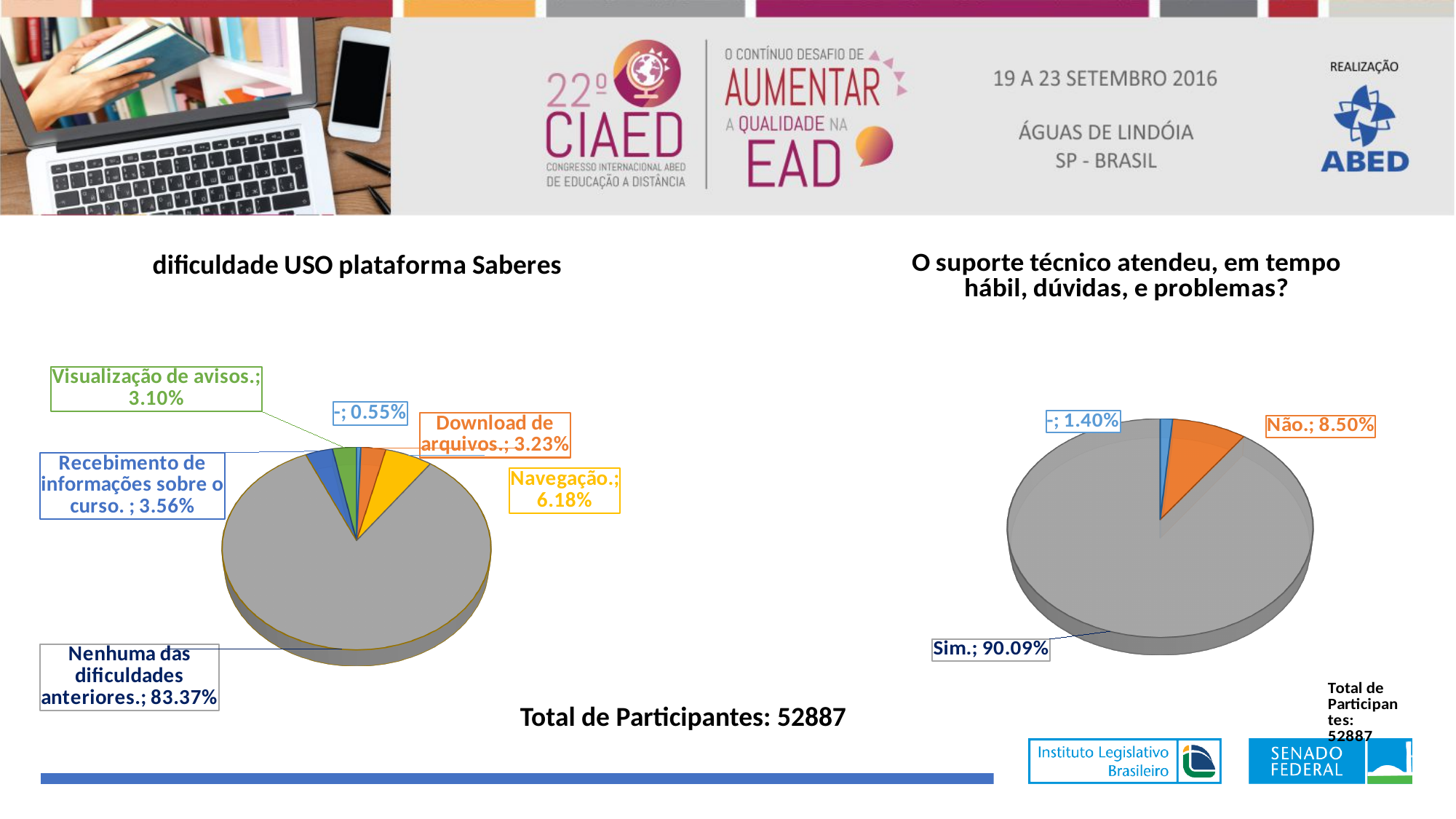
What kind of chart is the 'O suporte técnico atendeu, em tempo hábil, dúvidas, e problemas?' chart? Pie chart What total number of participants is stated on the slide? 52887 In the 'dificuldade USO plataforma Saberes' chart, which category has the smallest share? - In the 'dificuldade USO plataforma Saberes' chart, what share is labelled for 'Navegação.'? 6.18% In the 'dificuldade USO plataforma Saberes' chart, what is the difference between the shares for 'Navegação.' and 'Download de arquivos.'? 2.95% In the 'dificuldade USO plataforma Saberes' chart, what share is labelled for 'Nenhuma das dificuldades anteriores.'? 83.37% In the 'dificuldade USO plataforma Saberes' chart, what share is labelled for 'Download de arquivos.'? 3.23% In the 'dificuldade USO plataforma Saberes' chart, which is larger: 'Recebimento de informações sobre o curso.' or 'Visualização de avisos.'? Recebimento de informações sobre o curso. In the 'O suporte técnico atendeu, em tempo hábil, dúvidas, e problemas?' chart, what is the difference between the shares for 'Não.' and '-'? 7.10% In the 'O suporte técnico atendeu, em tempo hábil, dúvidas, e problemas?' chart, what share is labelled for 'Não.'? 8.50% In the 'O suporte técnico atendeu, em tempo hábil, dúvidas, e problemas?' chart, what share is labelled for 'Sim.'? 90.09% How many slices does the 'dificuldade USO plataforma Saberes' chart have? 6